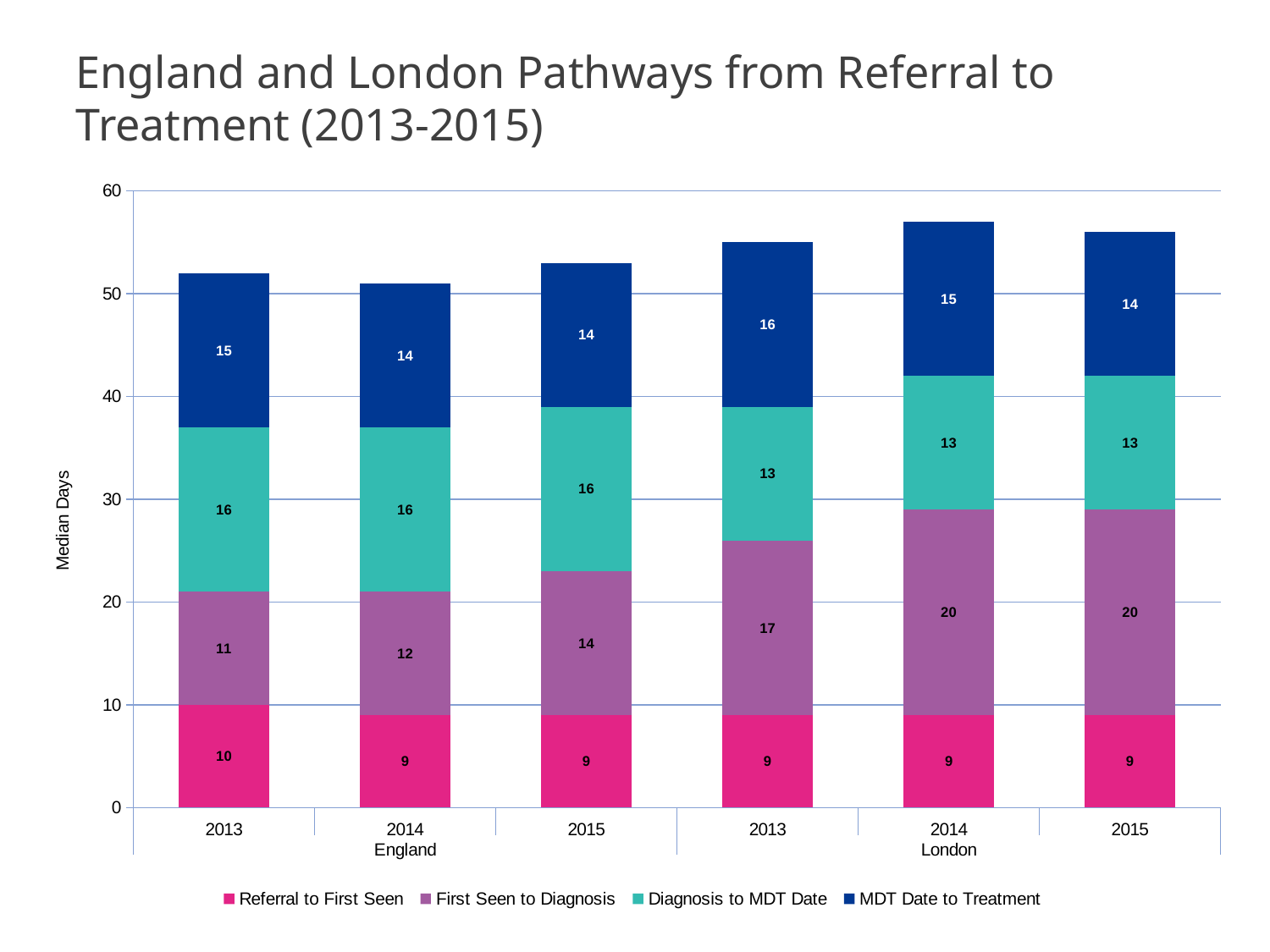
What kind of chart is shown on the slide? Stacked bar chart What is the total median days for the London 2014 bar? 57 What is the value of First Seen to Diagnosis for London in 2014? 20 Which is larger: Diagnosis to MDT Date for England 2013 or for London 2013? England 2013 How many series does the legend list? 4 Which bar has the highest total median days? London 2014 What is the value of MDT Date to Treatment for London in 2013? 16 What is the total median days for the England 2014 bar? 51 What is the difference between First Seen to Diagnosis for London 2015 and England 2015? 6 What is the label of the y axis? Median Days How many bars are plotted in the chart? 6 What is the value of Referral to First Seen for England in 2013? 10